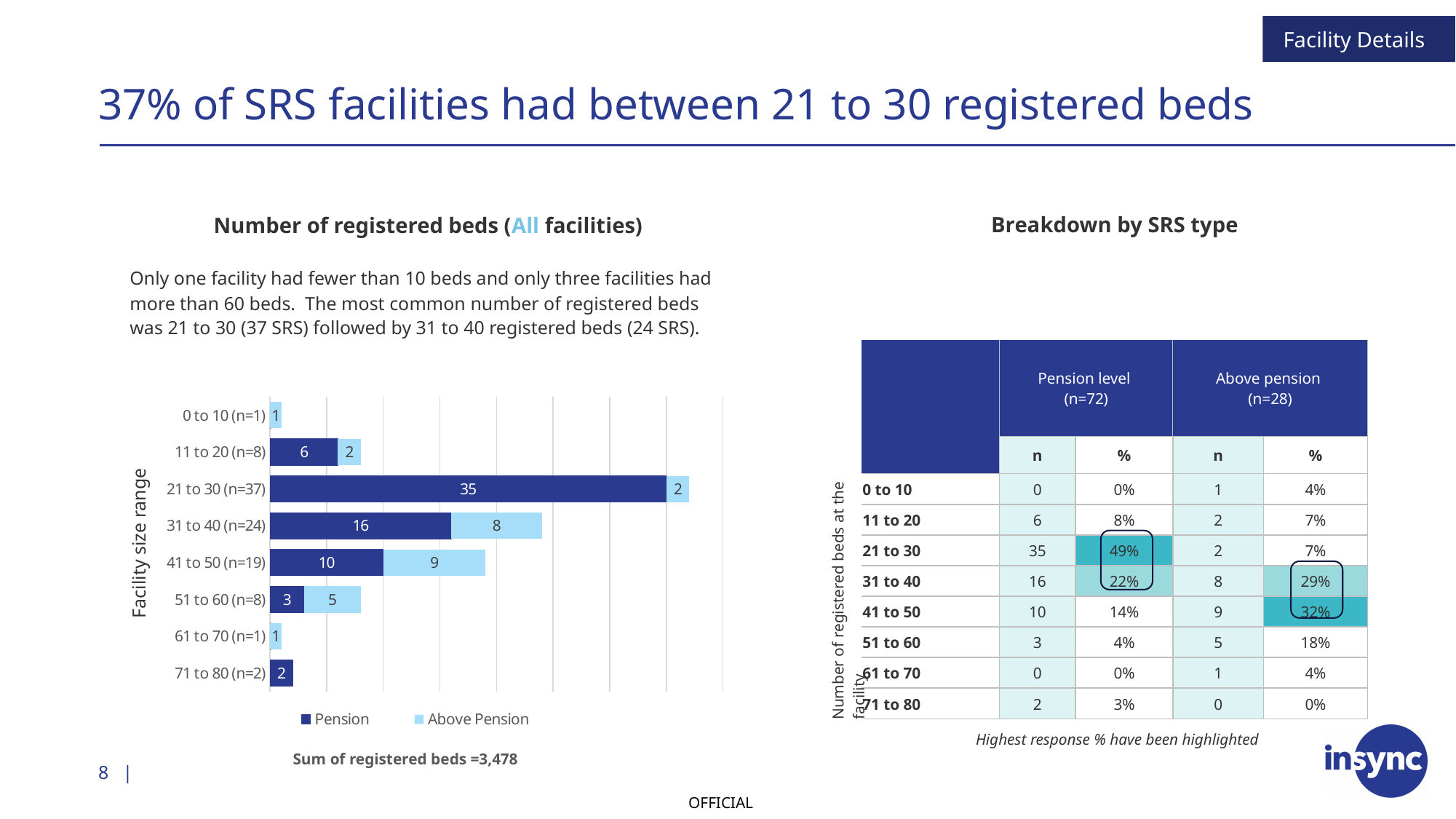
In the bar chart, what is the difference between the Pension and Above Pension values for the 31 to 40 facility size range? 8 What is the sum of registered beds stated below the bar chart? 3,478 What kind of chart is shown under the title 'Number of registered beds (All facilities)'? Stacked bar chart Which facility size range has the highest Above Pension value in the bar chart? 41 to 50 (n=19) Which facility size range has the highest Pension value in the bar chart? 21 to 30 (n=37) How many facility size ranges are shown on the bar chart? 8 In the bar chart, what is the Above Pension value for the 41 to 50 facility size range? 9 In the bar chart, is the Pension value or the Above Pension value larger for the 51 to 60 facility size range? Above Pension In the bar chart, what is the Pension value for the 31 to 40 facility size range? 16 In the bar chart, what is the Pension value for the 21 to 30 facility size range? 35 In the bar chart, what is the total of the stacked bar for the 31 to 40 facility size range? 24 How many series does the legend of the bar chart list? 2